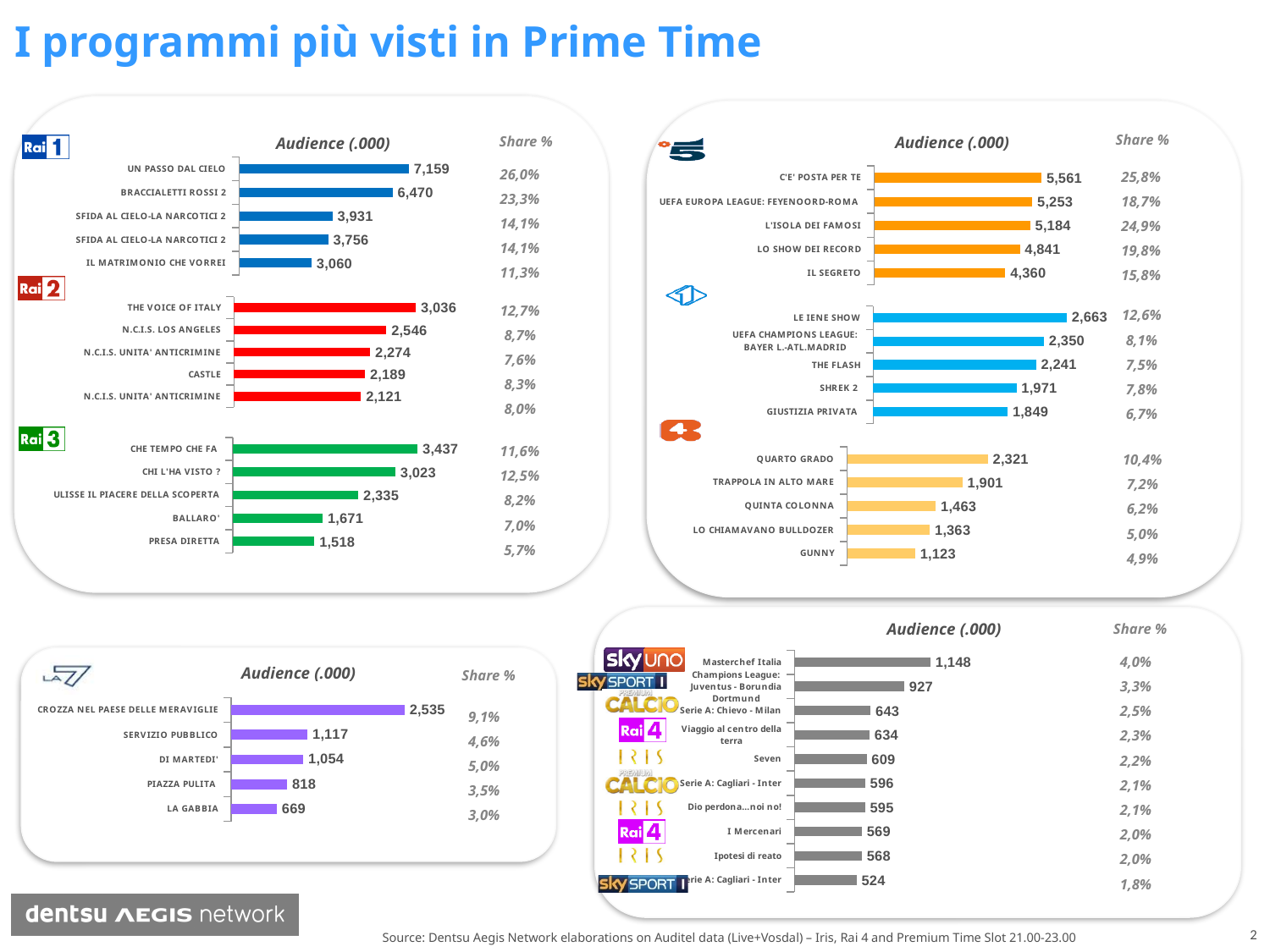
In the top-right chart (Mediaset channels), which Rete 4 programme has the lowest audience? GUNNY In the top-left chart (Rai channels), what is the audience (.000) for UN PASSO DAL CIELO? 7,159 In the bottom-left chart (La7), what is the audience (.000) for CROZZA NEL PAESE DELLE MERAVIGLIE? 2,535 In the top-right chart (Mediaset channels), what is the audience (.000) for C'E' POSTA PER TE? 5,561 In the bottom-right chart (Sky/Premium/Rai 4/Iris), what is the share % for Seven? 2,2% What kind of chart is used in the bottom-left (La7) panel? Bar chart In the top-left chart (Rai channels), which Rai 3 programme has the highest audience? CHE TEMPO CHE FA In the top-right chart (Mediaset channels), what is the difference in audience (.000) between LE IENE SHOW and GIUSTIZIA PRIVATA? 814 In the bottom-left chart (La7), which has the larger audience, SERVIZIO PUBBLICO or DI MARTEDI'? SERVIZIO PUBBLICO In the bottom-right chart (Sky/Premium/Rai 4/Iris), what is the audience (.000) for Masterchef Italia? 1,148 In the top-left chart (Rai channels), what is the share % for THE VOICE OF ITALY? 12,7% In the bottom-left chart (La7), how many programmes are listed? 5